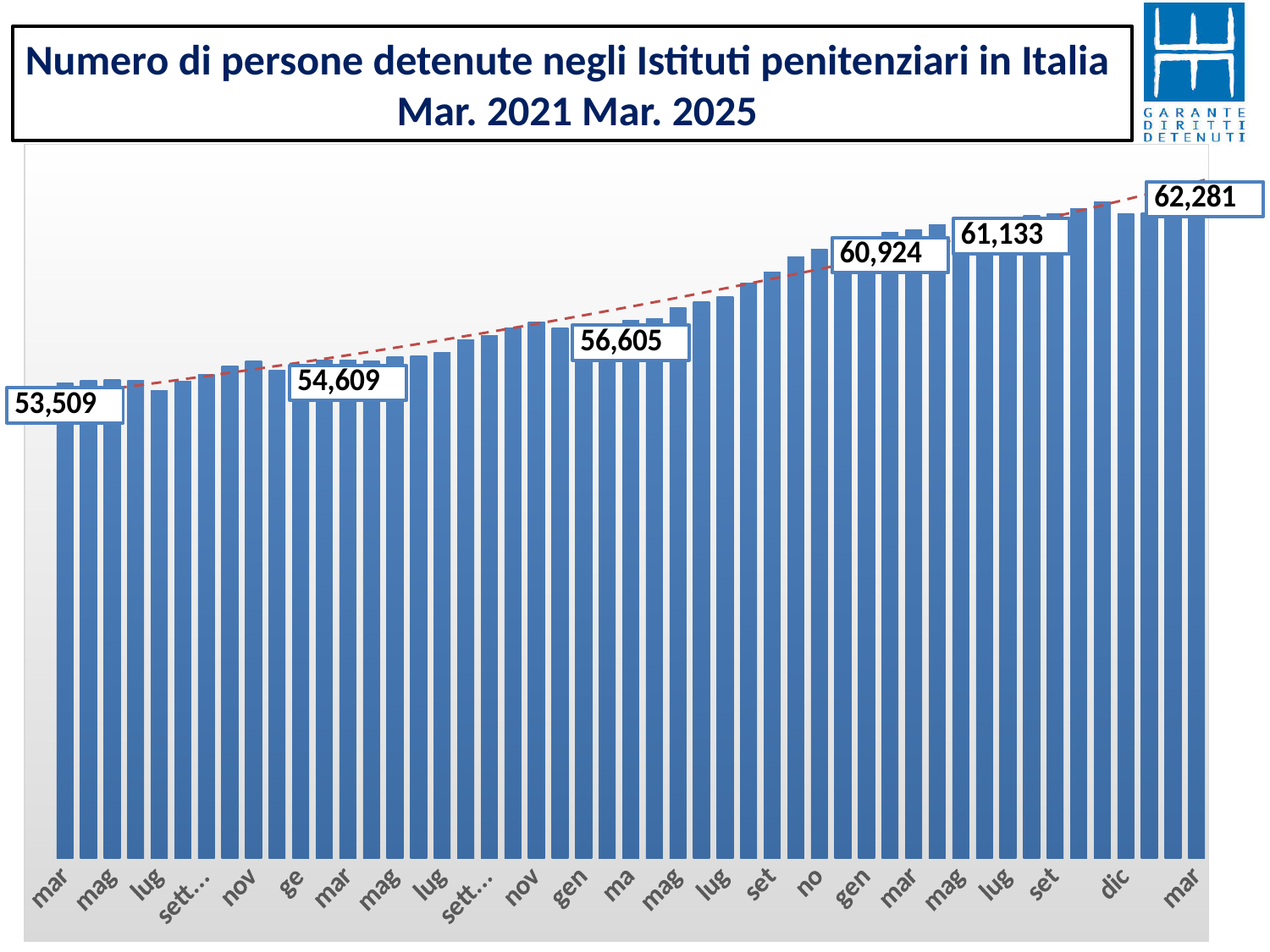
Do the values generally rise or fall from March 2021 to March 2025? rise Which is larger, the value for mar 2021 or the value for mar 2025? mar 2025 What is the highest value printed as a data label on the chart? 62,281 How many data labels are printed on the chart? 6 What is the title of the chart? Numero di persone detenute negli Istituti penitenziari in Italia Mar. 2021 Mar. 2025 What is the lowest value printed as a data label on the chart? 53,509 What kind of chart is shown on the slide? bar chart What is the difference between the last labelled value (62,281) and the first labelled value (53,509)? 8,772 What colour is the dashed trend line drawn across the bars? red What is the value shown for the first bar (mar 2021)? 53,509 What is the value shown for the last bar (mar 2025)? 62,281